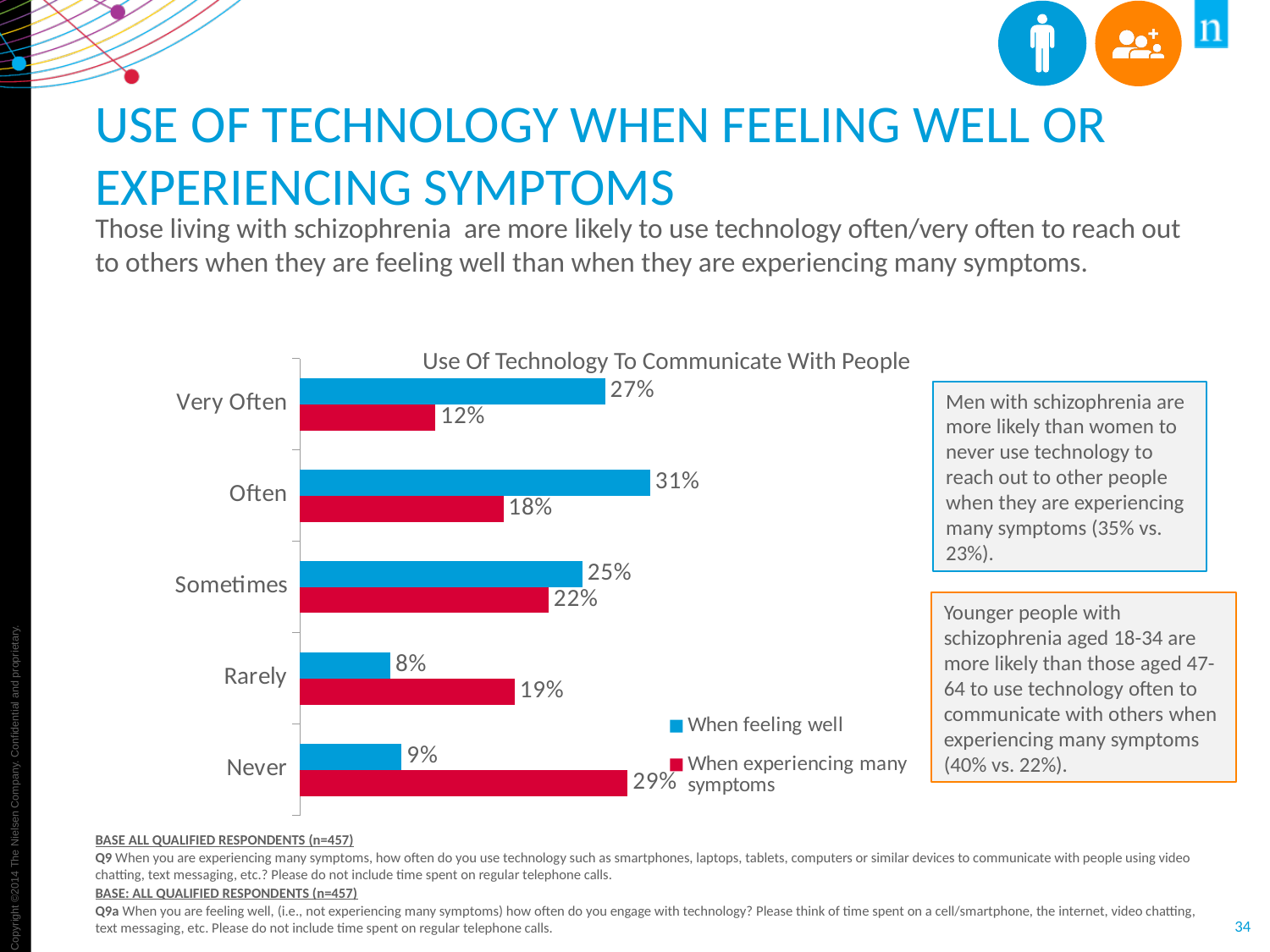
What is the difference between the When feeling well and When experiencing many symptoms values for Often? 13% What kind of chart is shown on the slide? Bar chart What is the value for Never in the When experiencing many symptoms series? 29% What is the value for Very Often in the When feeling well series? 27% What is the value for Rarely in the When experiencing many symptoms series? 19% What is the title of the chart? Use Of Technology To Communicate With People How many series does the legend list? 2 Which category has the lowest value in the When experiencing many symptoms series? Very Often Which category has the highest value in the When feeling well series? Often How many categories are shown on the chart? 5 Which category has the lowest value in the When feeling well series? Rarely For Never, which series has the larger value: When feeling well or When experiencing many symptoms? When experiencing many symptoms